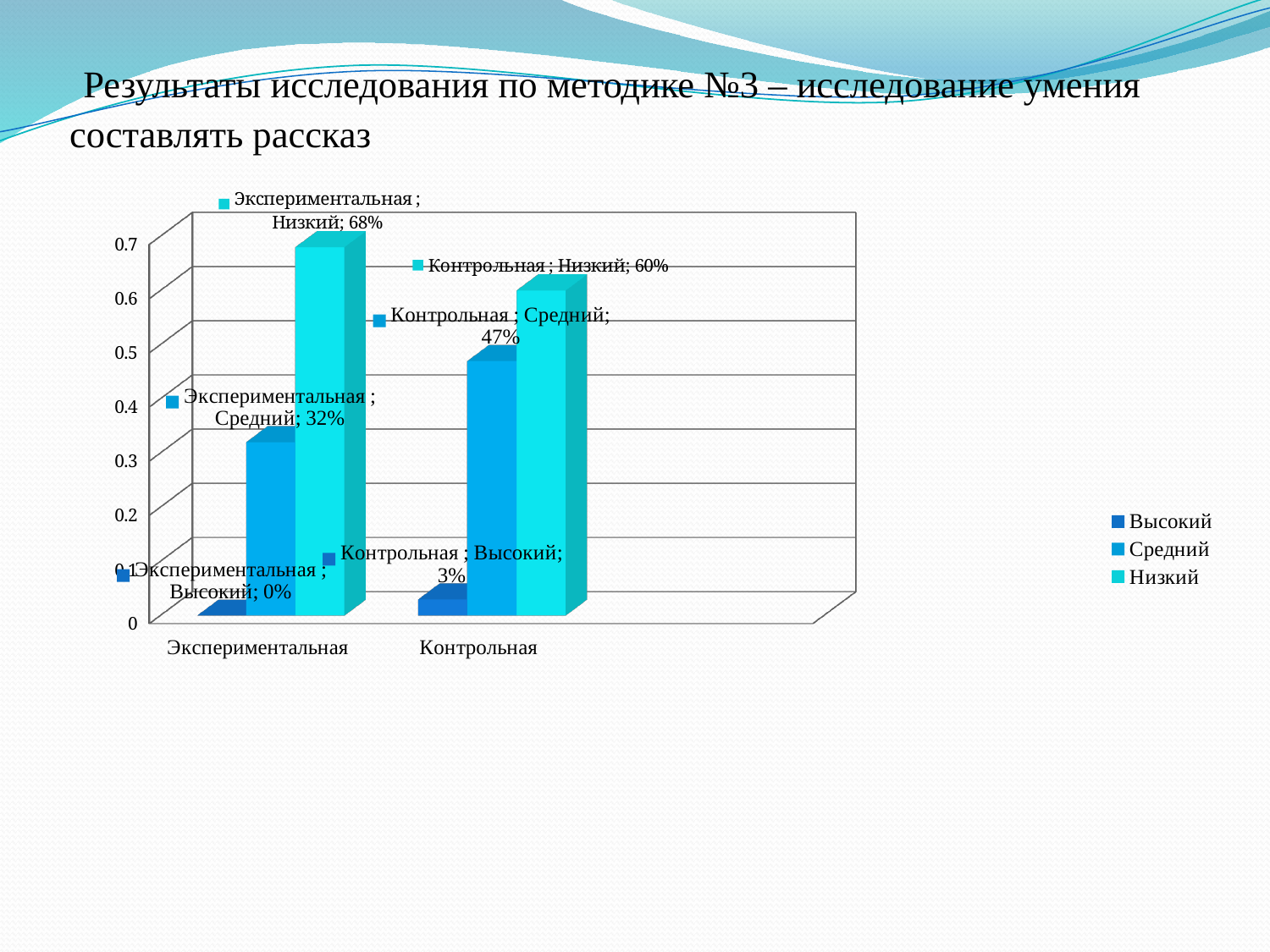
What are the three series names listed in the legend? Высокий, Средний, Низкий What kind of chart is shown on the slide? Bar chart How many groups (categories) are shown on the x axis? 2 Which level has the lowest value in the Экспериментальная group? Высокий What is the value for Высокий in the Экспериментальная group? 0% Which level has the highest value in the Контрольная group? Низкий What is the value for Низкий in the Экспериментальная group? 68% What is the difference between the Низкий values of the Экспериментальная and Контрольная groups? 8% How many series does the legend list? 3 Which group has the larger Средний value, Экспериментальная or Контрольная? Контрольная What is the value for Средний in the Контрольная group? 47% What is the value for Высокий in the Контрольная group? 3%